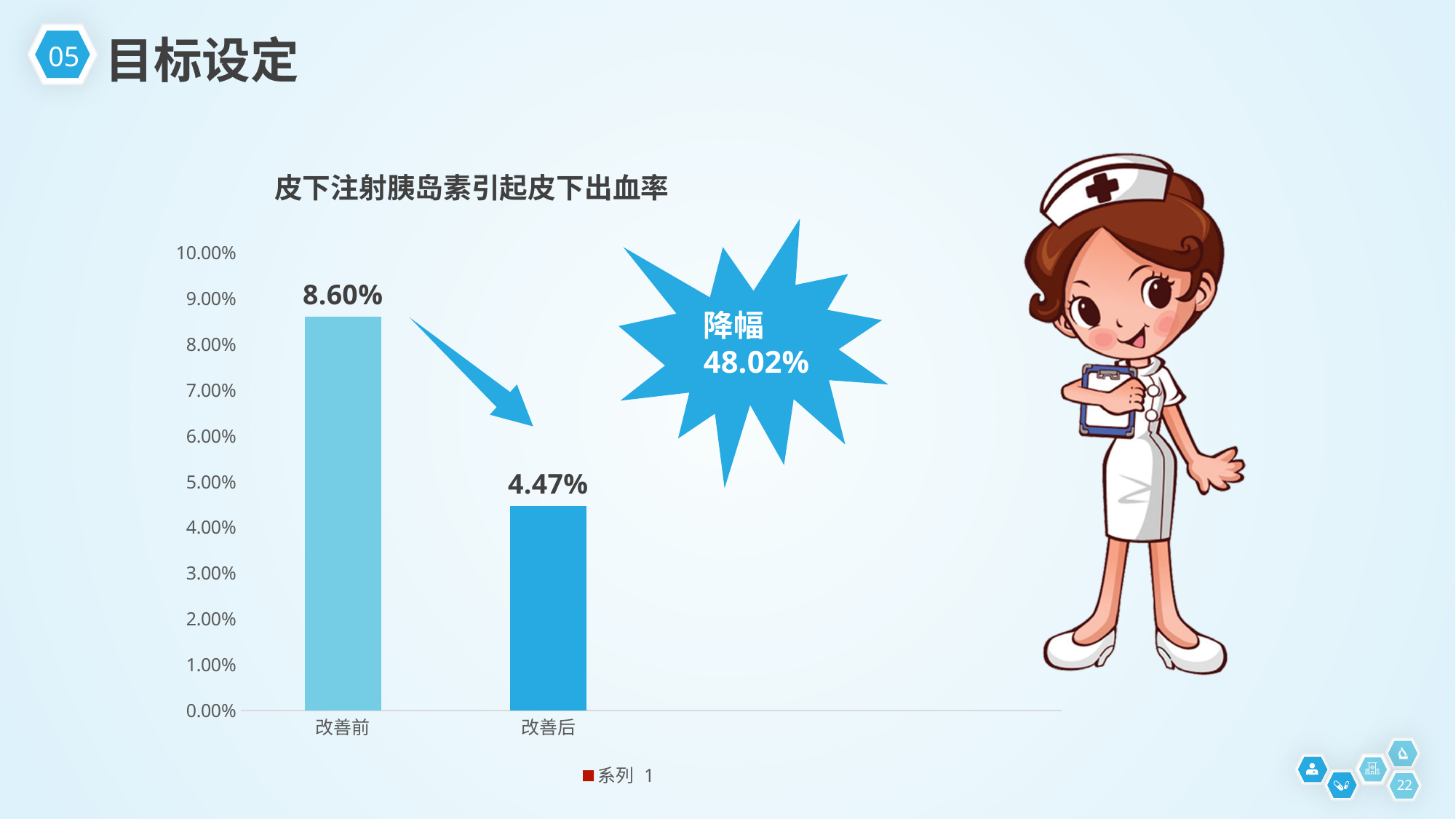
How many categories are shown on the x axis? 2 Is the value for 改善后 greater or less than 5.00%? less Is the value for 改善前 greater or less than 8.00%? greater What kind of chart is shown on the slide? bar chart What is the difference between the values for 改善前 and 改善后? 4.13% How many series does the legend list? 1 Which category has the highest value? 改善前 What is the value for 改善前? 8.60% Which is larger, the value for 改善前 or the value for 改善后? 改善前 What is the value for 改善后? 4.47% What is the title of the chart? 皮下注射胰岛素引起皮下出血率 Which category has the lowest value? 改善后